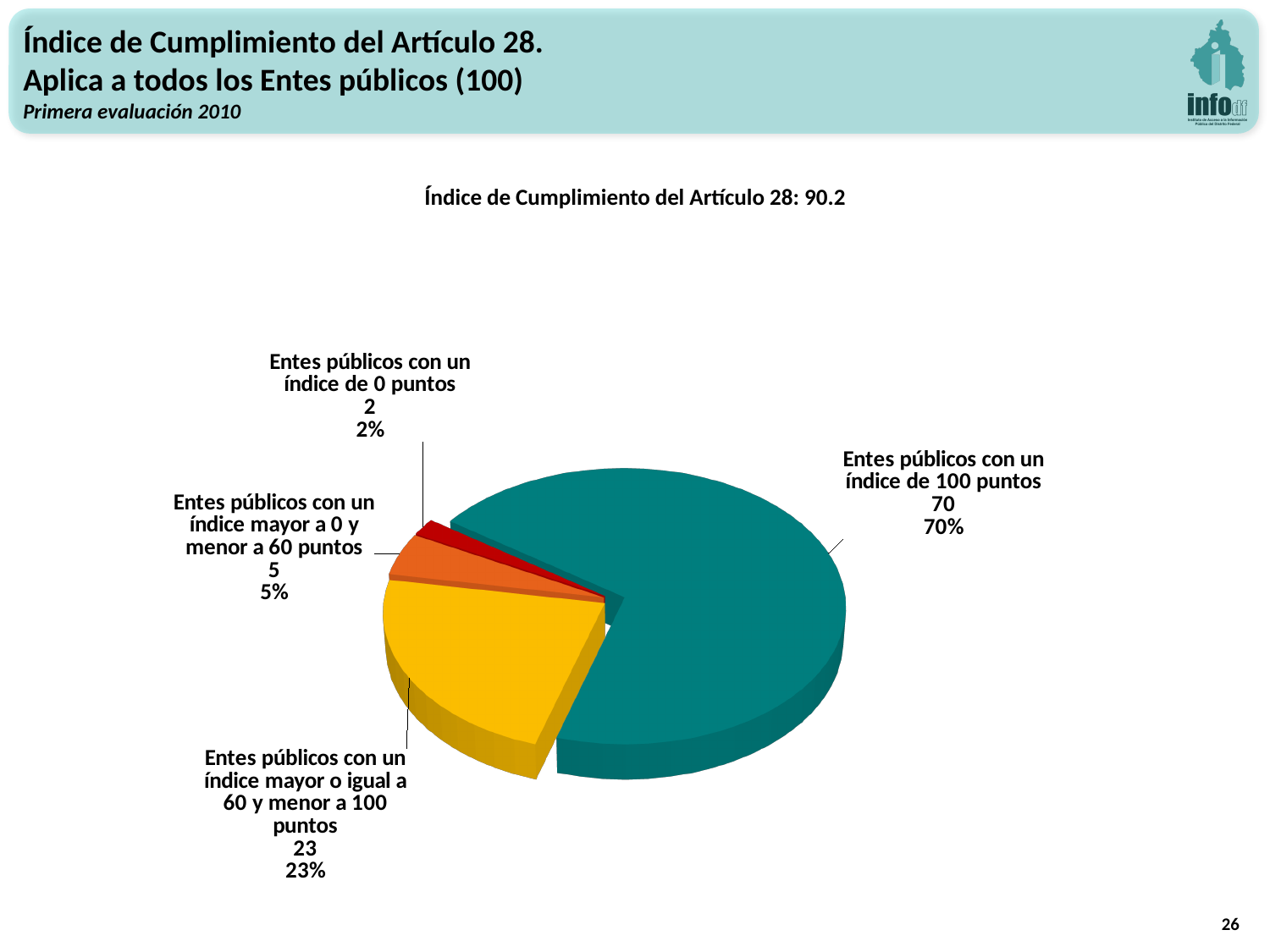
How many slices does the pie chart have? 4 What is the total number of public entities across all four slices? 100 What kind of chart is shown on the slide? pie chart What percentage of public entities have an index of 0 points? 2% Which is larger: the number of entities with an index greater than 0 and less than 60 points, or the number with an index of 0 points? Entes públicos con un índice mayor a 0 y menor a 60 puntos What is the Índice de Cumplimiento del Artículo 28 value stated above the chart? 90.2 Which category has the largest slice of the pie? Entes públicos con un índice de 100 puntos How many public entities have an index of 100 points? 70 How many public entities have an index greater than 0 and less than 60 points? 5 Which category has the smallest slice of the pie? Entes públicos con un índice de 0 puntos What is the difference between the number of entities with an index of 100 points and those with an index between 60 and 100 points? 47 What share of the pie corresponds to entities with an index greater than or equal to 60 and less than 100 points? 23%